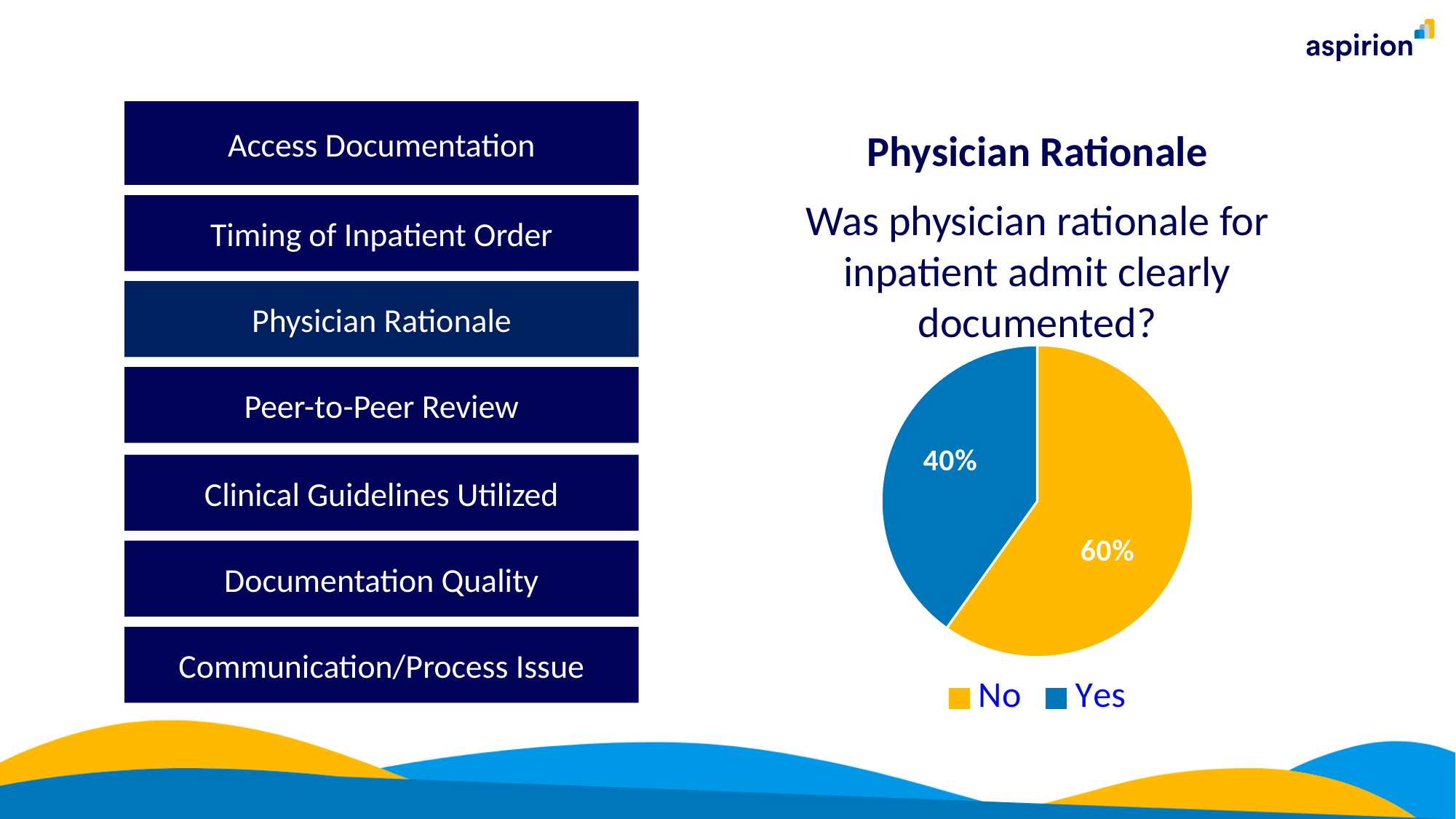
Which slice of the pie chart is the smallest? Yes What is the title of the chart? Physician Rationale Which slice of the pie chart is the largest? No How many slices does the pie chart have? 2 What percentage of the pie chart is labelled "Yes"? 40% What percentage of the pie chart is labelled "No"? 60% Which is larger in the pie chart, the "No" slice or the "Yes" slice? No What type of chart is shown on the slide? pie chart How many entries does the legend of the pie chart list? 2 What colour is the "Yes" slice in the pie chart? blue What is the difference in percentage points between the "No" slice and the "Yes" slice? 20%